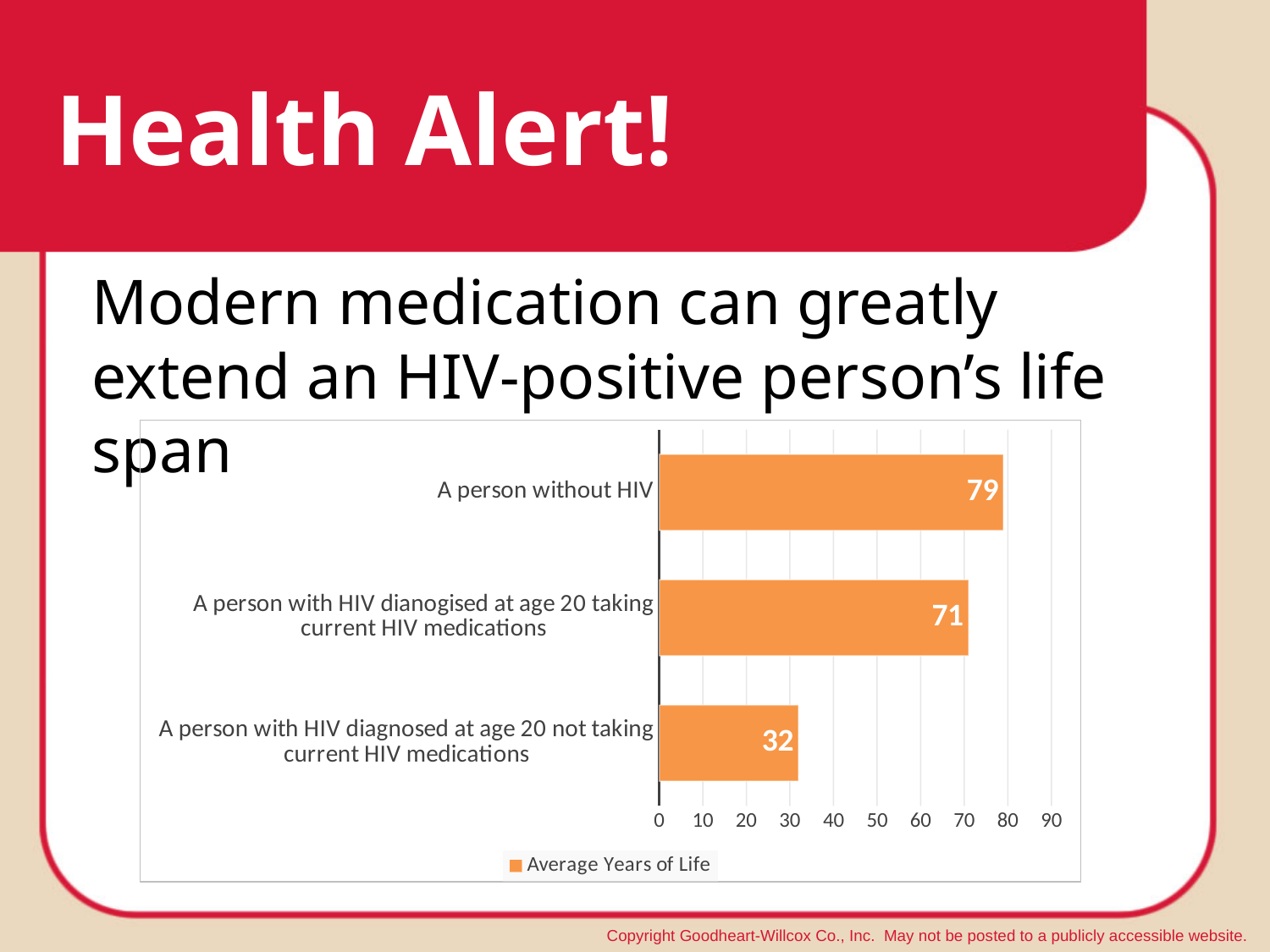
Which is larger: the average years of life for a person with HIV taking current medications or for a person with HIV not taking current medications? A person with HIV taking current medications What is the average years of life for a person with HIV diagnosed at age 20 taking current HIV medications? 71 What kind of chart is shown on the slide? Bar chart Is the value for a person with HIV diagnosed at age 20 not taking current HIV medications greater or less than 40? less What is the average years of life for a person without HIV? 79 Which category has the lowest average years of life? A person with HIV diagnosed at age 20 not taking current HIV medications How many categories are shown in the chart? 3 What is the difference in average years of life between a person with HIV diagnosed at age 20 taking current HIV medications and one not taking them? 39 How many series does the legend list? 1 Which category has the highest average years of life? A person without HIV What is the average years of life for a person with HIV diagnosed at age 20 not taking current HIV medications? 32 What is the difference in average years of life between a person without HIV and a person with HIV diagnosed at age 20 taking current HIV medications? 8